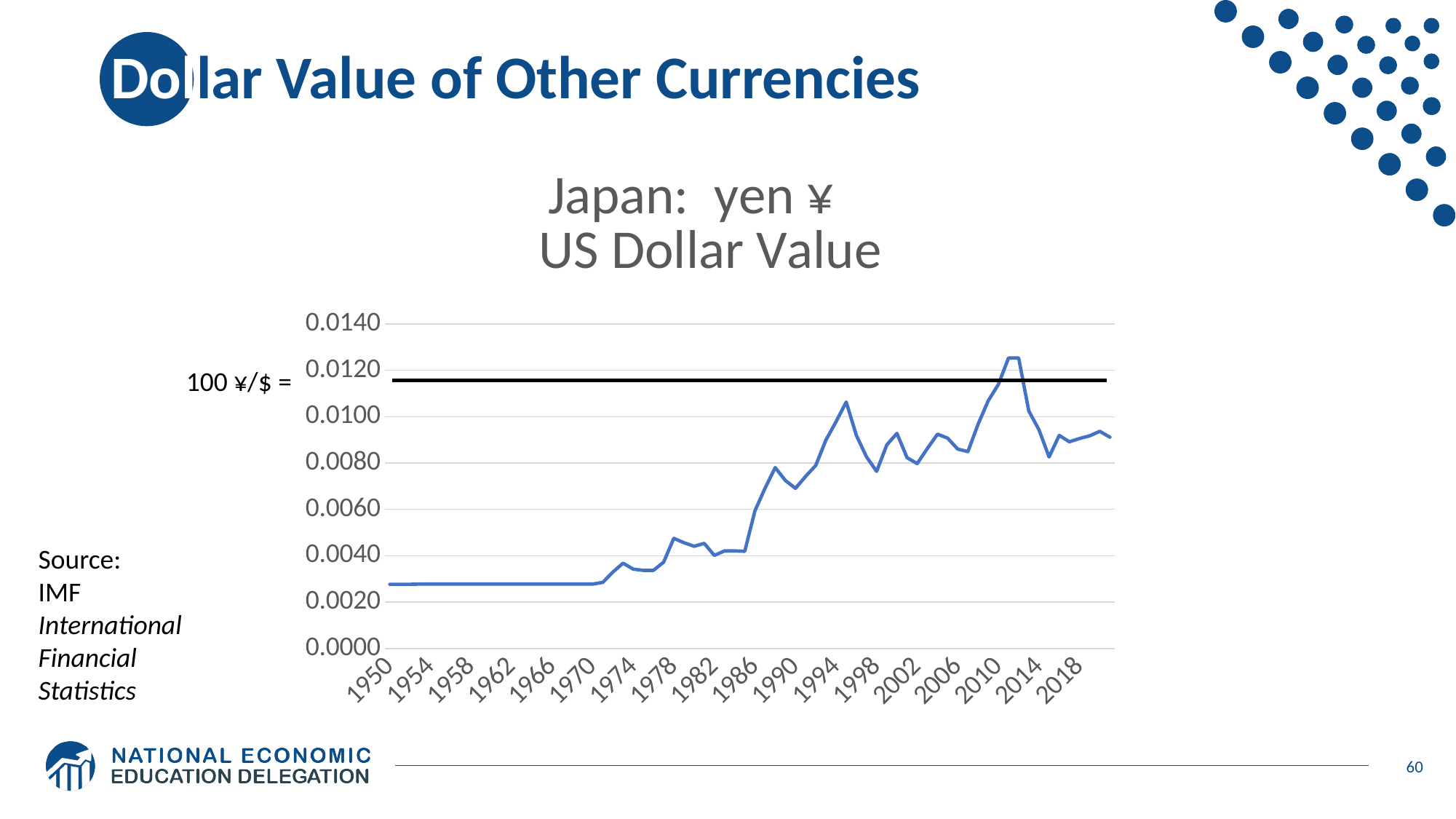
Overall, does the US dollar value of the yen rise or fall from 1950 to 2018? rise Which is larger, the value for 1950 or the value for 2018? 2018 Is the value for 1978 greater or less than 0.0040? greater What does the horizontal black reference line on the chart represent? 100 ¥/$ Is the value for 2010 greater or less than 0.0100? greater Is the value for 1970 greater or less than 0.0040? less What is the title of the chart? Japan: yen ¥ US Dollar Value What kind of chart is shown on the slide? line chart How many year labels are shown on the x axis? 18